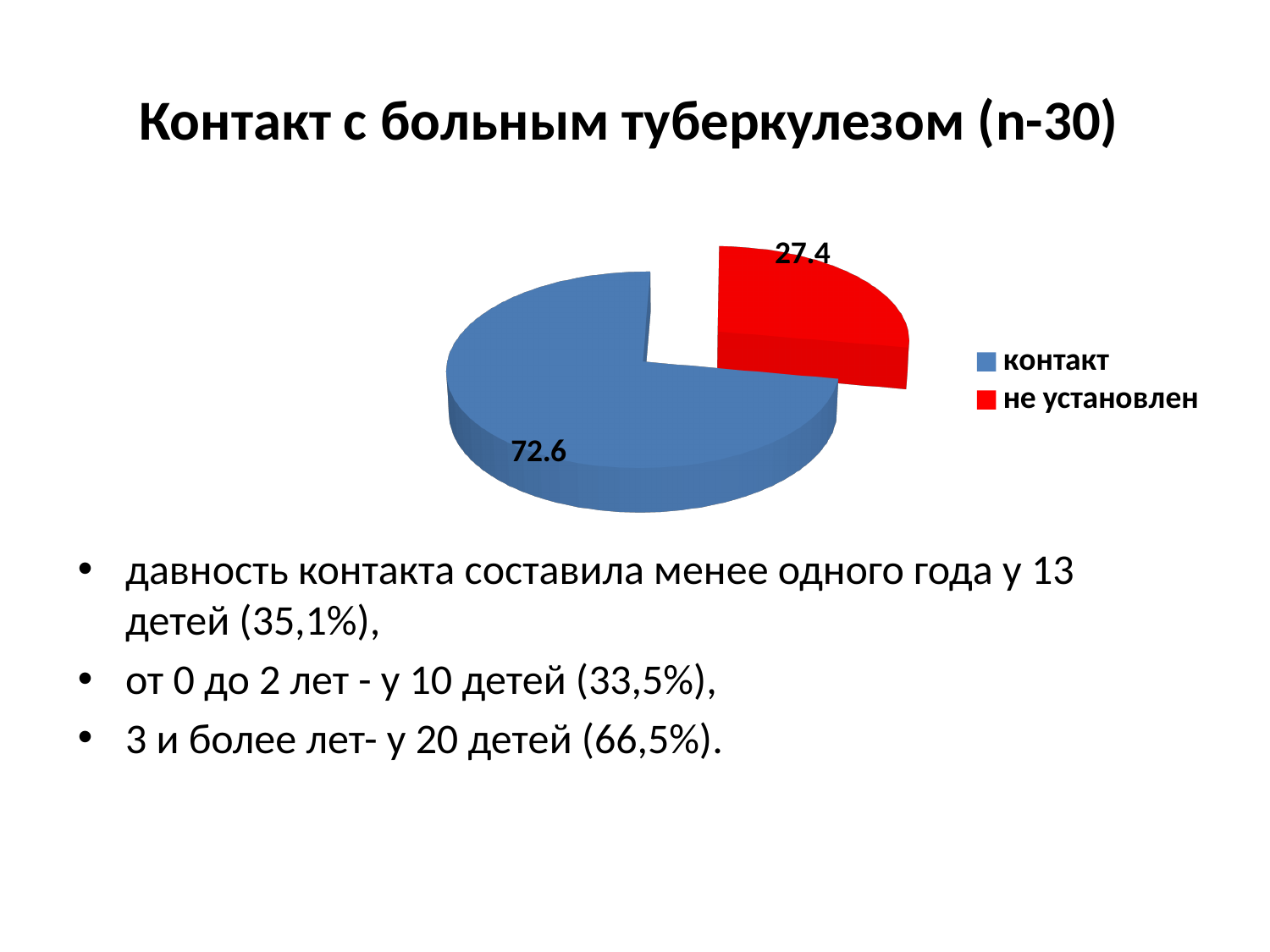
Which is larger, 'контакт' or 'не установлен'? контакт How many slices does the pie chart have? 2 Which slice is the largest? контакт What is the value for the 'не установлен' slice? 27.4 Which slice is the smallest? не установлен What is the value for the 'контакт' slice? 72.6 What type of chart is shown on the slide? pie chart What is the title of the slide containing the chart? Контакт с больным туберкулезом (n-30) How many entries does the legend list? 2 What colour is the 'не установлен' slice? red What is the difference between the 'контакт' and 'не установлен' values? 45.2